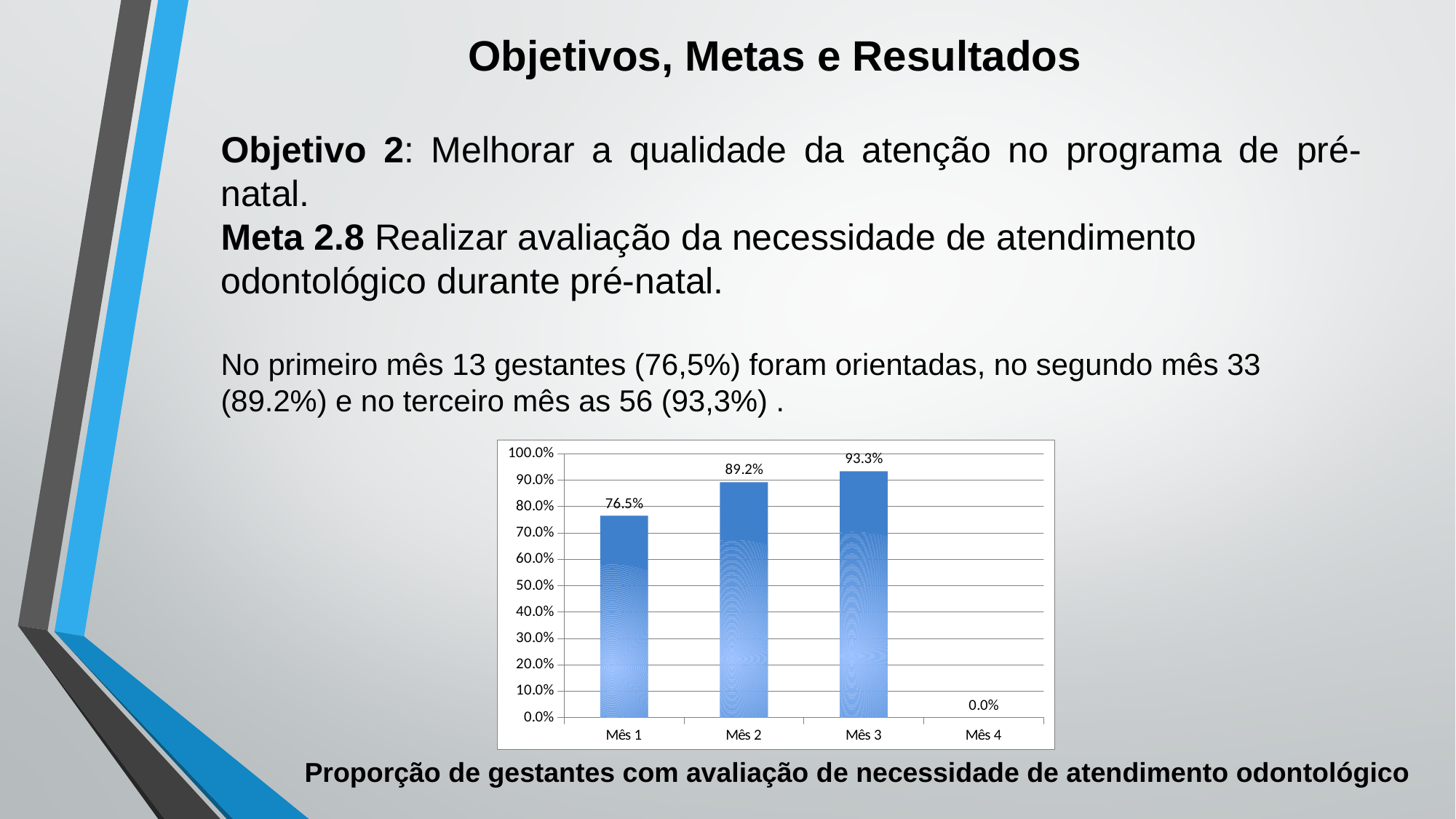
What is the value for Mês 3? 93.3% Which category has the lowest value? Mês 4 What is the value for Mês 4? 0.0% What kind of chart is shown on the slide? bar chart Which is larger, the value for Mês 2 or the value for Mês 1? Mês 2 Do the values rise or fall from Mês 1 to Mês 3? rise Is the value for Mês 2 greater or less than 80.0%? greater How many categories are shown on the x axis? 4 What is the difference between the values for Mês 3 and Mês 1? 16.8% What is the value for Mês 2? 89.2% Which category has the highest value? Mês 3 What is the value for Mês 1? 76.5%